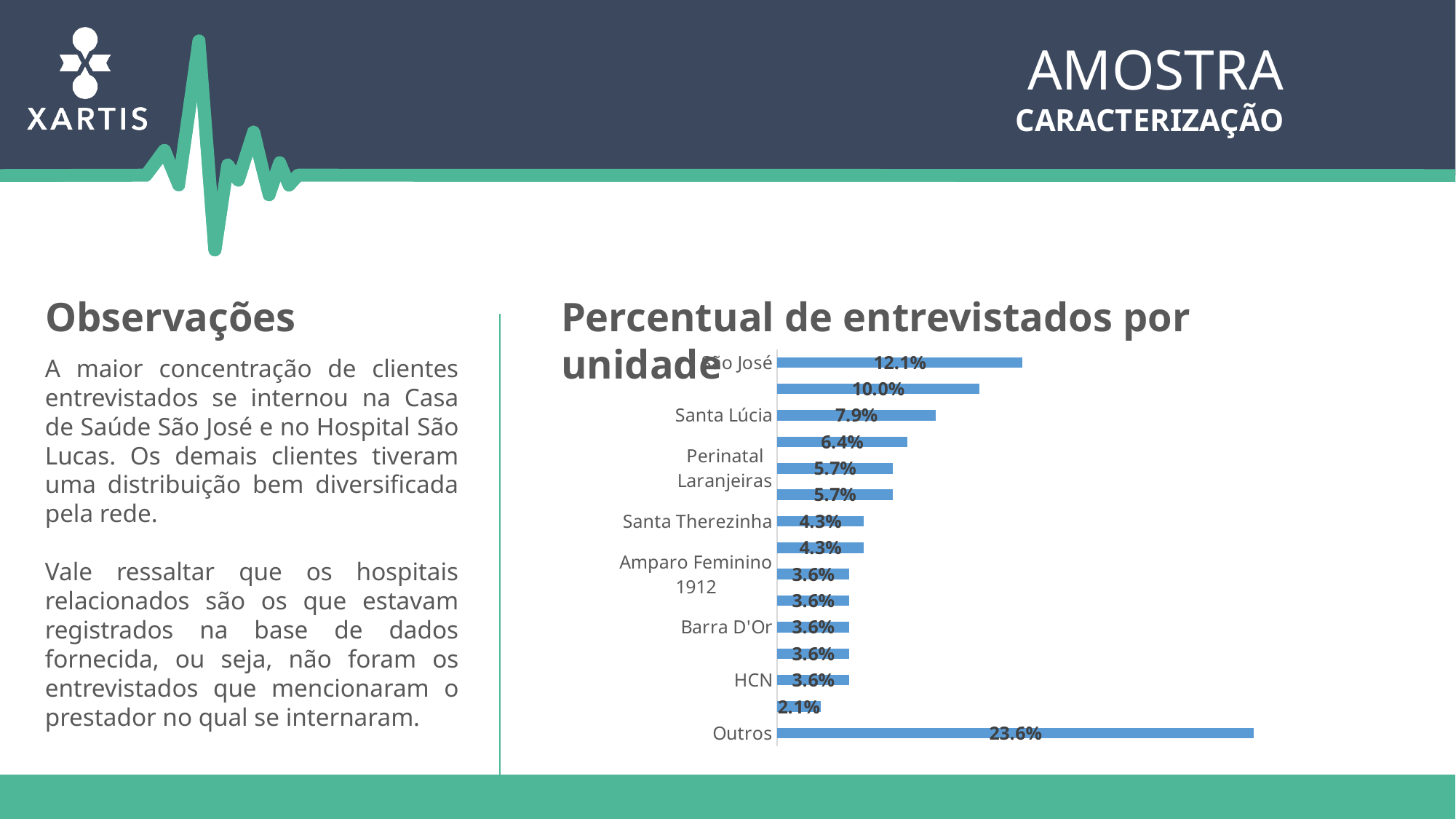
What is the value for Santa Therezinha? 4.3% Which category has the highest value? Outros How many bars are plotted on the chart? 15 What is the value for Perinatal Laranjeiras? 5.7% What is the value for Outros? 23.6% Which is larger, the value for Santa Lúcia or the value for Perinatal Laranjeiras? Santa Lúcia What is the smallest value shown on the chart? 2.1% What is the value for HCN? 3.6% What is the value for Santa Lúcia? 7.9% What is the difference between the values for Santa Lúcia and Santa Therezinha? 3.6% What kind of chart is shown on the slide? bar chart What is the value for Barra D'Or? 3.6%